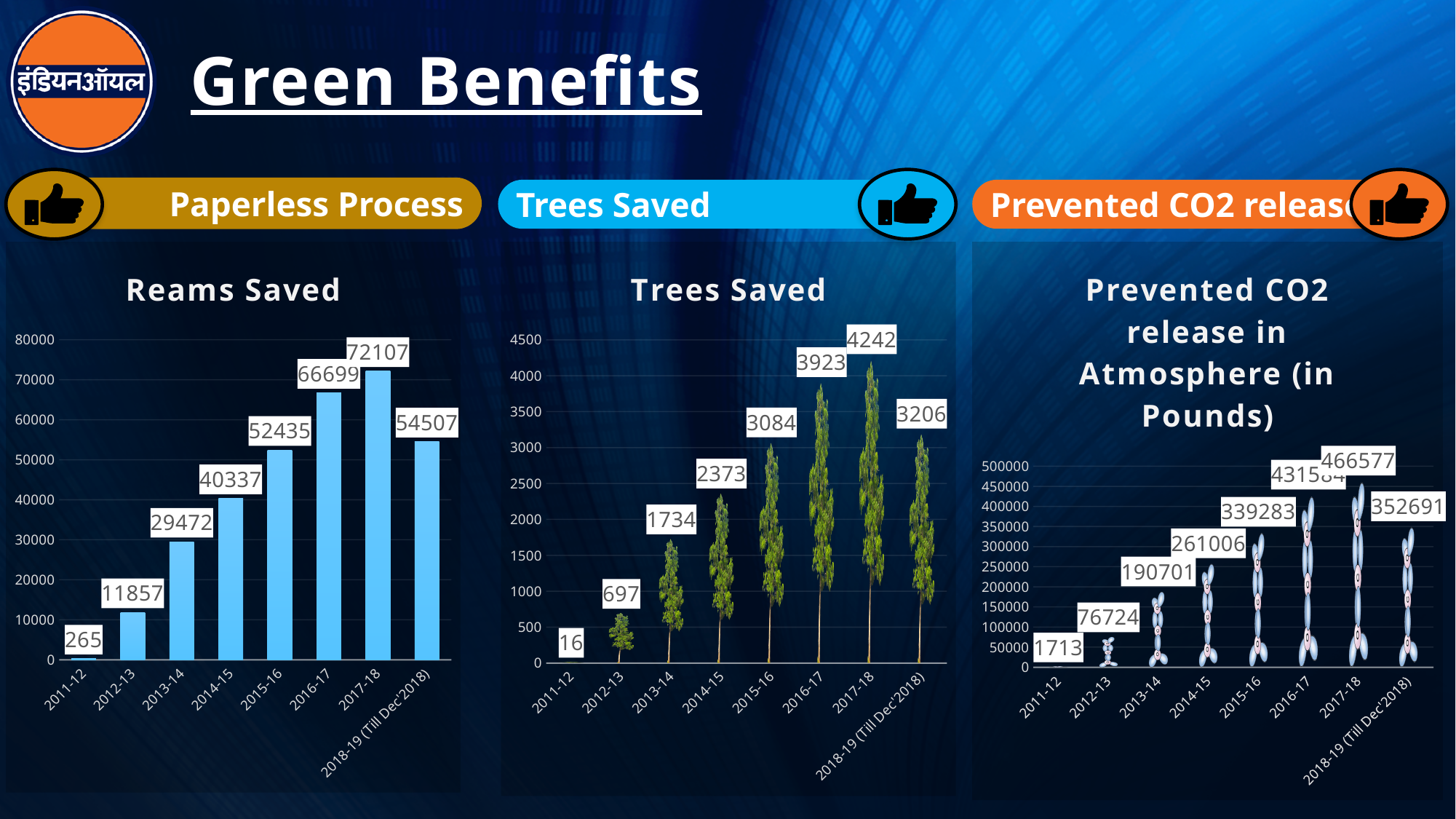
What kind of chart is the Reams Saved chart? bar chart In the Reams Saved chart, what is the value for 2015-16? 52435 In the Prevented CO2 release in Atmosphere chart, what is the value for 2013-14? 190701 In the Trees Saved chart, is the value for 2016-17 greater or less than 3500? greater In the Reams Saved chart, which year has the lowest value? 2011-12 In the Reams Saved chart, which year has the highest value? 2017-18 In the Trees Saved chart, which year has the highest value? 2017-18 In the Prevented CO2 release in Atmosphere chart, which is larger, the value for 2015-16 or the value for 2018-19 (Till Dec'2018)? 2018-19 (Till Dec'2018) In the Prevented CO2 release in Atmosphere chart, which year has the highest value? 2017-18 In the Trees Saved chart, what is the value for 2014-15? 2373 In the Trees Saved chart, how many years are shown on the x axis? 8 In the Reams Saved chart, what is the difference between the values for 2017-18 and 2016-17? 5408